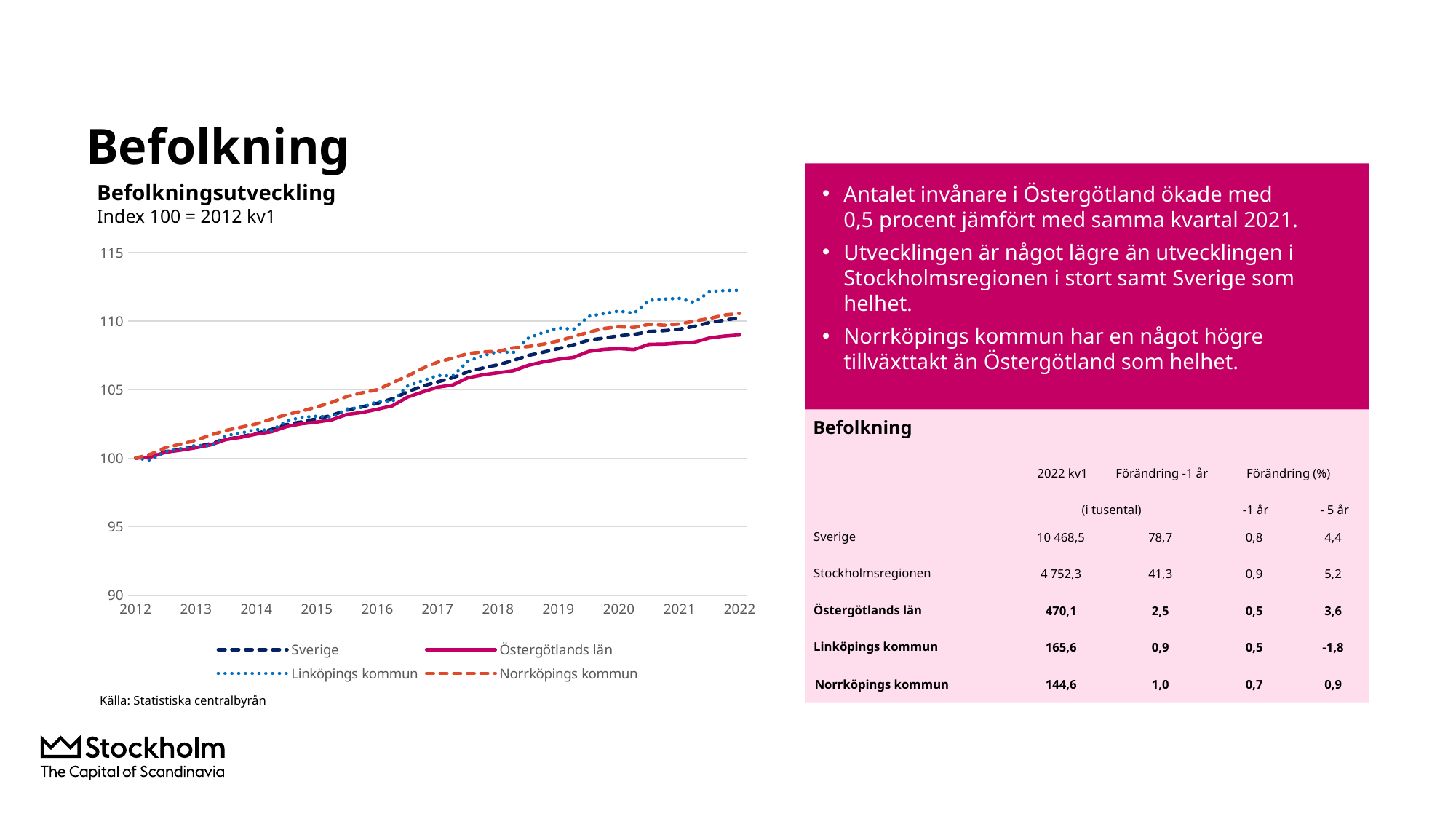
Is the index value for Linköpings kommun in 2022 greater or less than 110? greater Is the index value for Östergötlands län in 2022 greater or less than 110? less Is the index value for Östergötlands län in 2016 greater or less than 105? less How many year labels are shown on the x axis of the chart? 11 Which series has the lowest index value at the end of the chart in 2022? Östergötlands län What is the base index value and period stated in the chart subtitle? Index 100 = 2012 kv1 At 2022, which is larger: the index for Linköpings kommun or for Östergötlands län? Linköpings kommun What kind of chart is shown under the title 'Befolkningsutveckling'? line chart How many series does the legend of the 'Befolkningsutveckling' chart list? 4 Do the index values in the chart rise or fall from 2012 to 2022? rise Which series has the highest index value at the end of the chart in 2022? Linköpings kommun